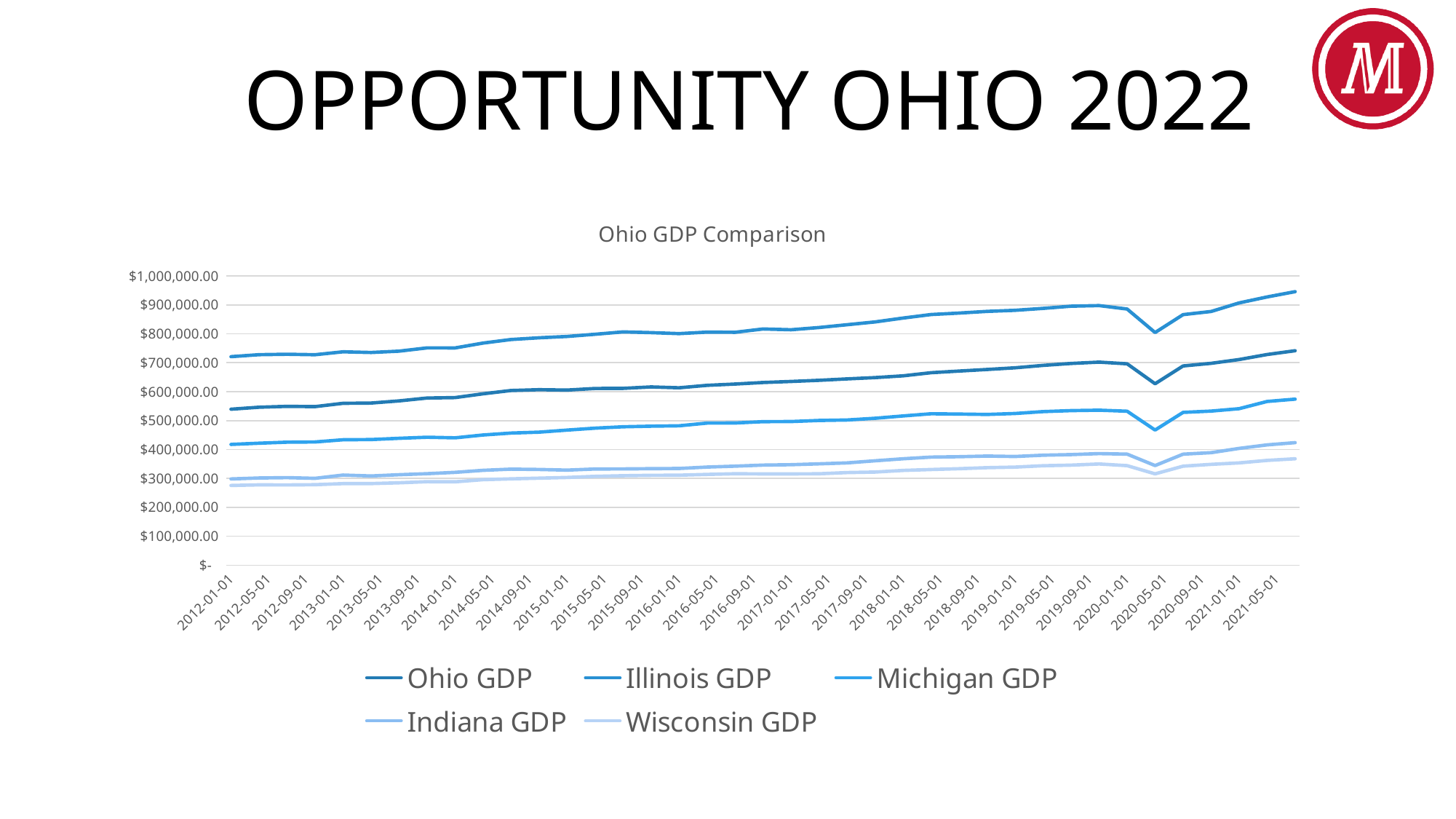
How many series does the legend of the chart list? 5 Around which x-axis date do all five series show a sharp dip? 2020-05-01 Is the value for Michigan GDP at 2021-05-01 greater or less than $500,000.00? greater Is the value for Wisconsin GDP at 2012-01-01 greater or less than $300,000.00? less What kind of chart is shown on the slide? Line chart Which series has the highest values throughout the chart? Illinois GDP Which series has the lowest values throughout the chart? Wisconsin GDP What is the title of the chart? Ohio GDP Comparison Is the value for Ohio GDP at 2012-01-01 greater or less than $500,000.00? greater Which is larger at 2012-01-01, Ohio GDP or Michigan GDP? Ohio GDP Does Ohio GDP generally rise or fall from 2012-01-01 to 2021-05-01? Rise